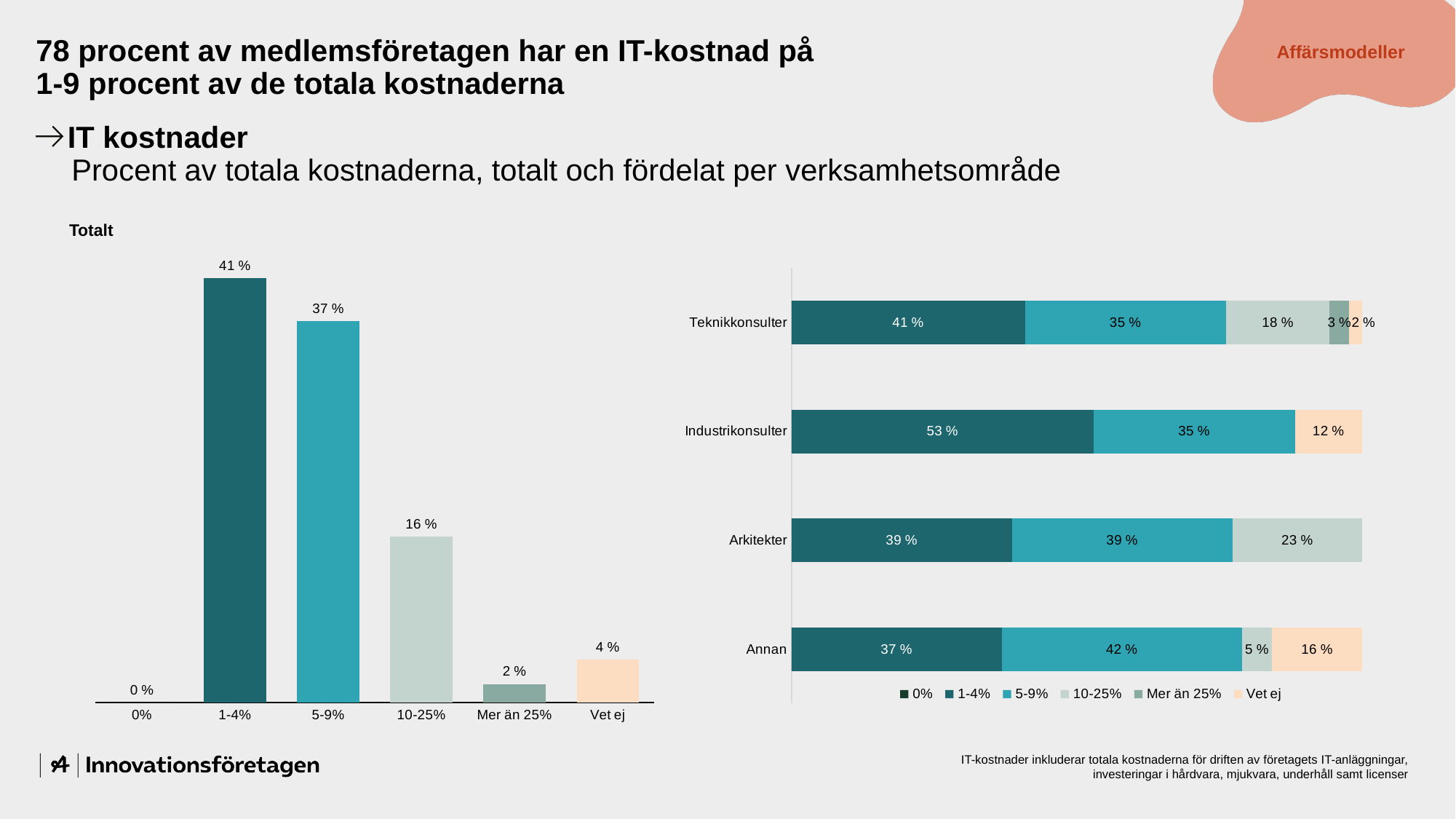
What kind of chart is the "Totalt" chart on the left? Bar chart In the "Totalt" chart on the left, which category has the highest value? 1-4% How many series does the legend of the stacked bar chart on the right list? 6 In the "Totalt" chart on the left, what is the value for the 10-25% category? 16 % In the stacked bar chart on the right, which is larger: the 10-25% value for Arkitekter or the 10-25% value for Teknikkonsulter? Arkitekter In the stacked bar chart on the right, what is the difference between the Vet ej values for Annan and Industrikonsulter? 4 % In the "Totalt" chart on the left, how many categories are shown on the x axis? 6 In the "Totalt" chart on the left, which category has the lowest value? 0% In the stacked bar chart on the right, what is the 1-4% value for Industrikonsulter? 53 % In the stacked bar chart on the right, what is the 5-9% value for Annan? 42 % In the "Totalt" chart on the left, what is the difference between the 1-4% and 5-9% values? 4 % In the "Totalt" chart on the left, what is the value for the 1-4% category? 41 %